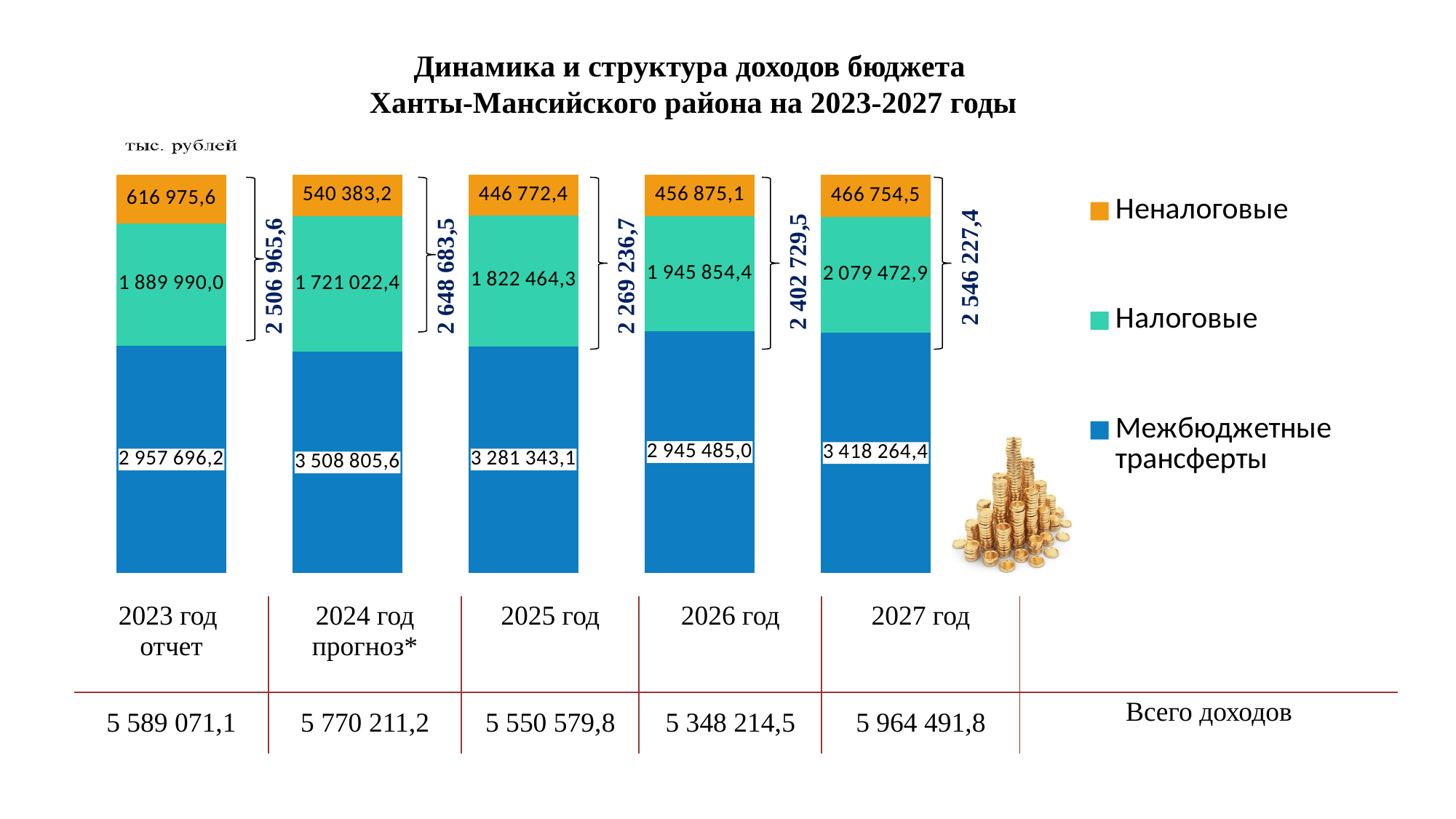
Which is larger: Межбюджетные трансферты in 2023 год or in 2026 год? 2023 год How many years (bars) are shown in the chart? 5 What is the total income (Всего доходов) for 2027 год? 5 964 491,8 What kind of chart is shown on the slide? Stacked bar chart Which year has the lowest value for Неналоговые? 2025 год Which year has the highest value for Межбюджетные трансферты? 2024 год прогноз* What is the value of Межбюджетные трансферты for 2025 год? 3 281 343,1 What is the value of Налоговые for 2027 год? 2 079 472,9 What is the difference between the Налоговые values for 2027 год and 2026 год? 133 618,5 What is the value of Неналоговые for 2023 год отчет? 616 975,6 How many series does the legend list? 3 Do the Налоговые values rise or fall from 2024 год to 2027 год? Rise